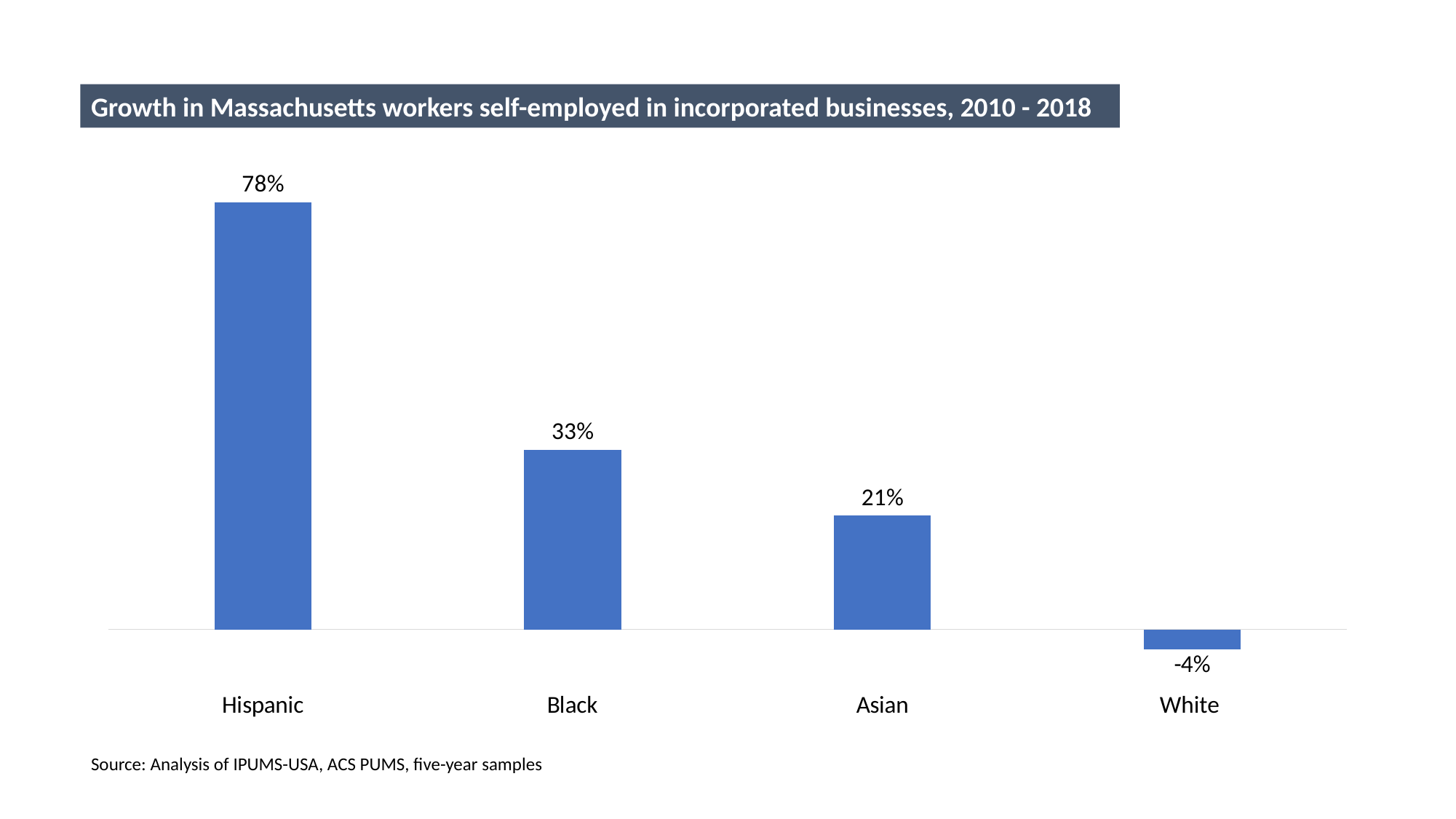
What kind of chart is shown on the slide? Bar chart What is the difference between the growth values for Black and Asian workers? 12% What is the growth value shown for Hispanic workers? 78% Which group has the lowest growth value? White How many groups are shown on the chart? 4 Which group has the highest growth value? Hispanic What is the growth value shown for Black workers? 33% What is the growth value shown for Asian workers? 21% Which is larger, the growth value for Asian workers or for White workers? Asian What is the title of the chart? Growth in Massachusetts workers self-employed in incorporated businesses, 2010 - 2018 What is the growth value shown for White workers? -4% What is the difference between the growth values for Hispanic and Black workers? 45%